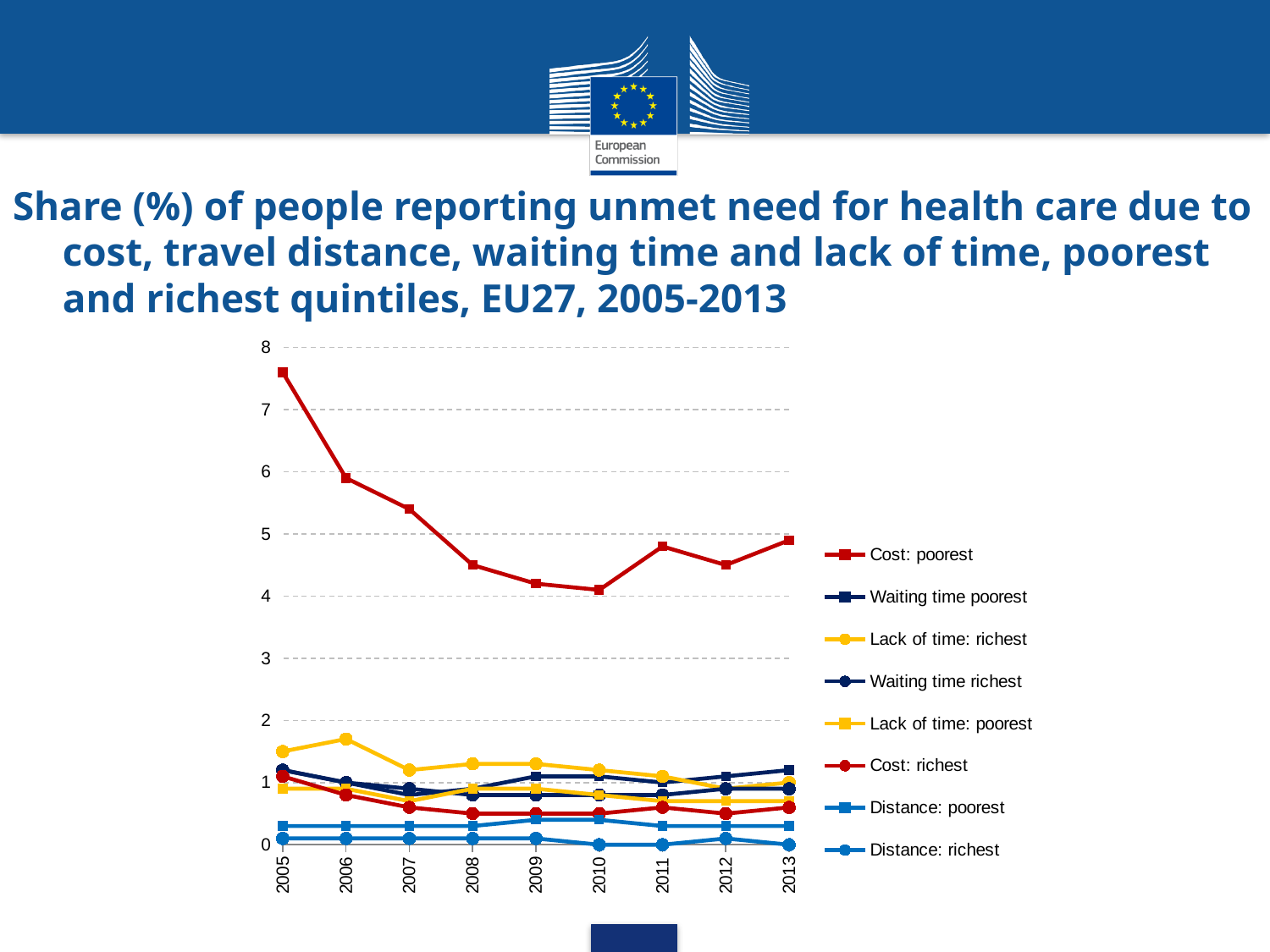
Is the value for Distance: richest in 2013 greater or less than 1? less Which series has the highest values across all years? Cost: poorest Is the value for Cost: poorest in 2005 greater or less than 7? greater Does the value for Cost: poorest rise or fall from 2005 to 2008? fall What colour is the line for Cost: poorest? red How many years are plotted along the x axis? 9 In 2013, which is larger: Cost: poorest or Cost: richest? Cost: poorest In which year is the value for Cost: poorest highest? 2005 Is the value for Cost: poorest in 2008 greater or less than 5? less How many series does the legend list? 8 What kind of chart is shown on the slide? line chart In which year is the value for Cost: poorest lowest? 2010